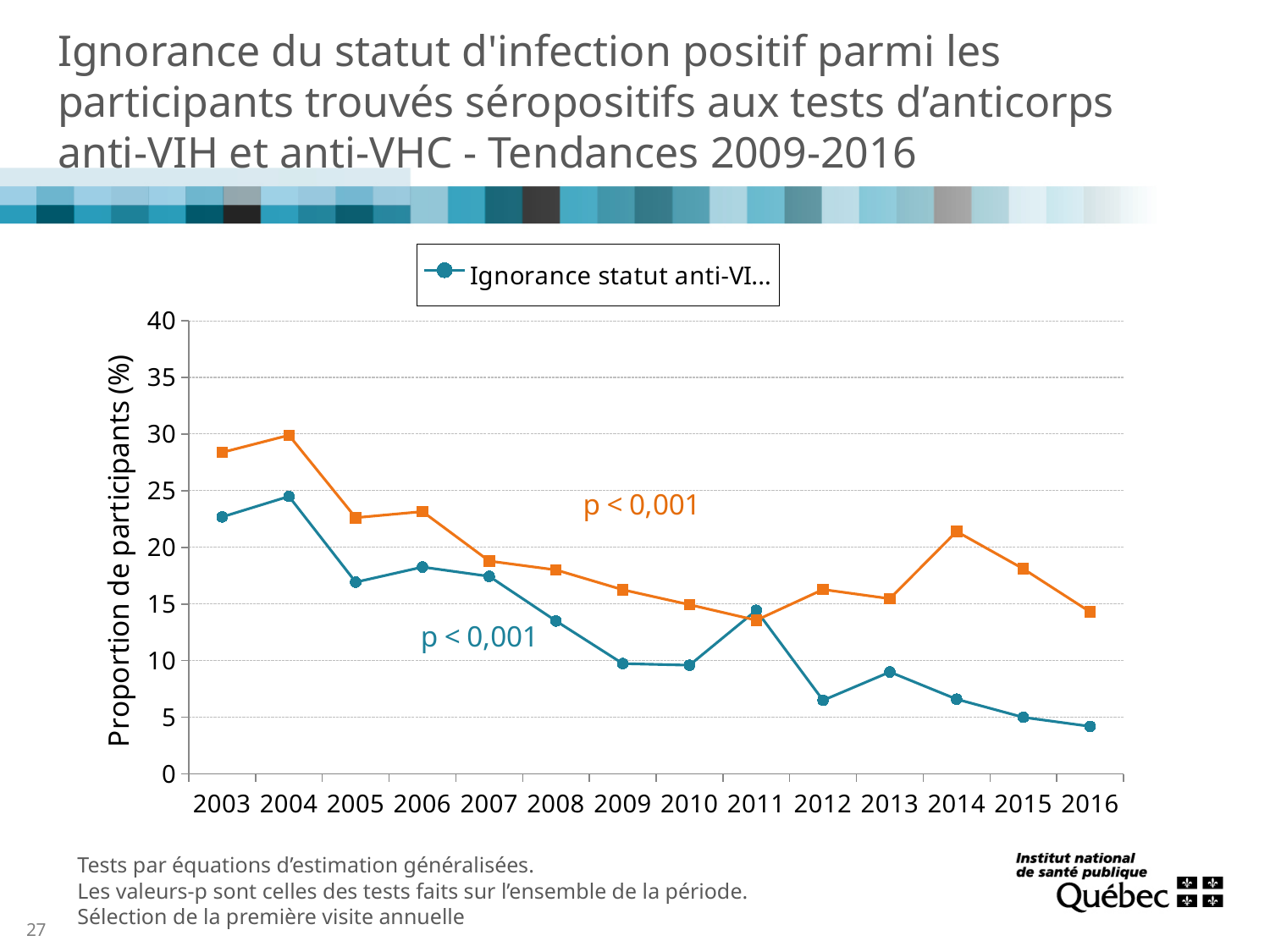
In which year does the orange square series reach its highest value? 2004 Is the value of the blue circle series in 2003 greater or less than 20? greater Is the value of the orange square series in 2004 greater or less than 25? greater In 2014, which series has the higher value, the blue circle series or the orange square series? orange square series What kind of chart is shown on the slide? line chart What is the title of the y axis? Proportion de participants (%) In which year does the blue circle series reach its lowest value? 2016 How many years are plotted along the x axis? 14 What p-value annotation is printed next to each line? p < 0,001 In which year does the blue circle series reach its highest value? 2004 Is the value of the blue circle series in 2012 greater or less than 10? less How many series does the legend list? 1